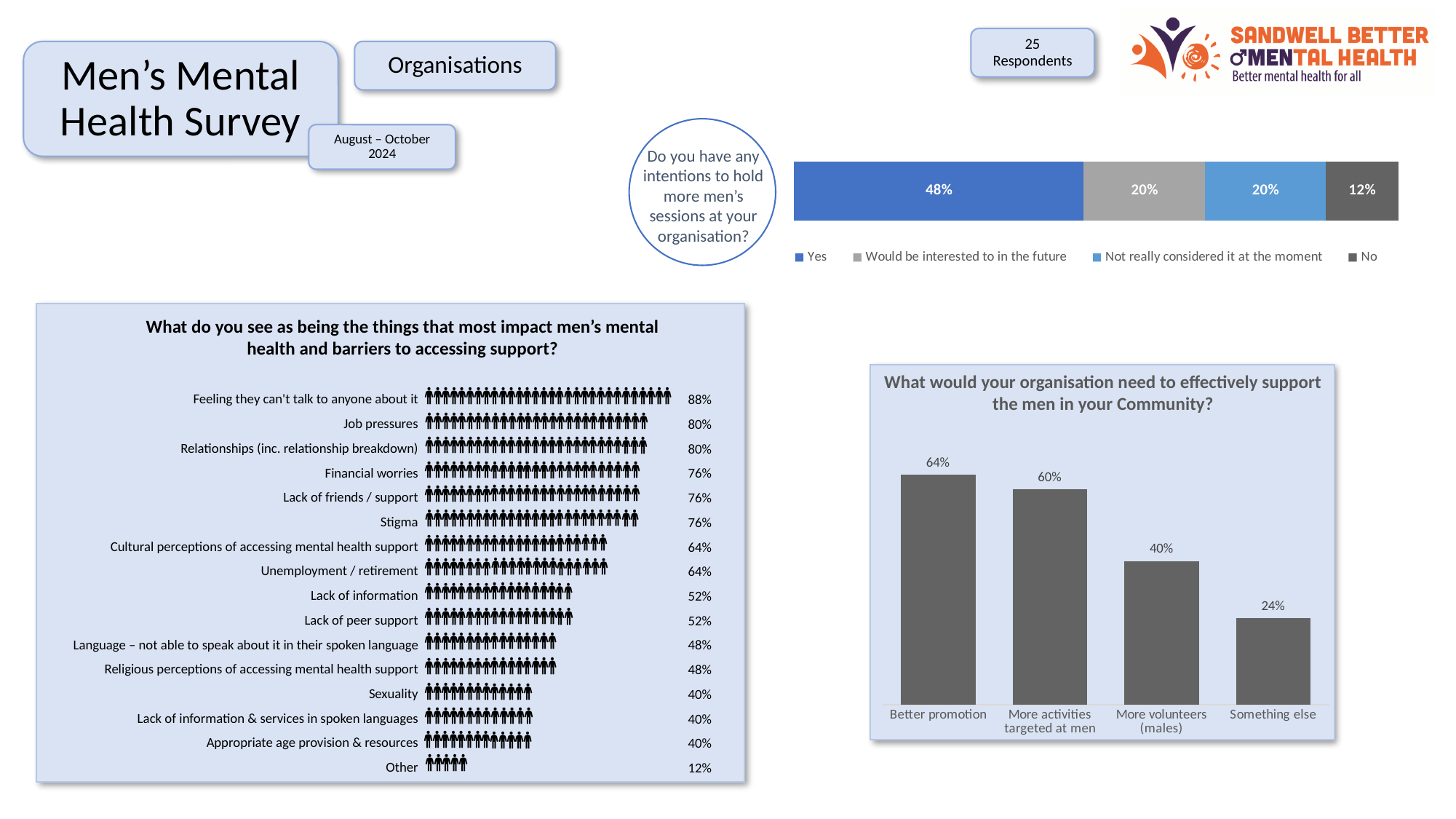
What kind of chart is 'What would your organisation need to effectively support the men in your Community?' Bar chart In the chart 'What would your organisation need to effectively support the men in your Community?', what is the difference between 'More activities targeted at men' and 'More volunteers (males)'? 20% In the chart 'What would your organisation need to effectively support the men in your Community?', which category has the lowest value? Something else How many entries does the legend list for the chart 'Do you have any intentions to hold more men's sessions at your organisation?' 4 In the chart 'What do you see as being the things that most impact men's mental health and barriers to accessing support?', which item has the highest value? Feeling they can't talk to anyone about it In the chart 'What would your organisation need to effectively support the men in your Community?', do the values rise or fall from left to right? Fall In the stacked bar for 'Do you have any intentions to hold more men's sessions at your organisation?', what percentage answered 'Yes'? 48% In the stacked bar for 'Do you have any intentions to hold more men's sessions at your organisation?', what percentage answered 'No'? 12% In the chart 'What would your organisation need to effectively support the men in your Community?', what is the value for 'Better promotion'? 64% In the chart 'What would your organisation need to effectively support the men in your Community?', how many categories are shown? 4 In the chart 'What do you see as being the things that most impact men's mental health and barriers to accessing support?', which is larger: 'Lack of information' or 'Sexuality'? Lack of information In the chart 'What do you see as being the things that most impact men's mental health and barriers to accessing support?', what is the value for 'Stigma'? 76%